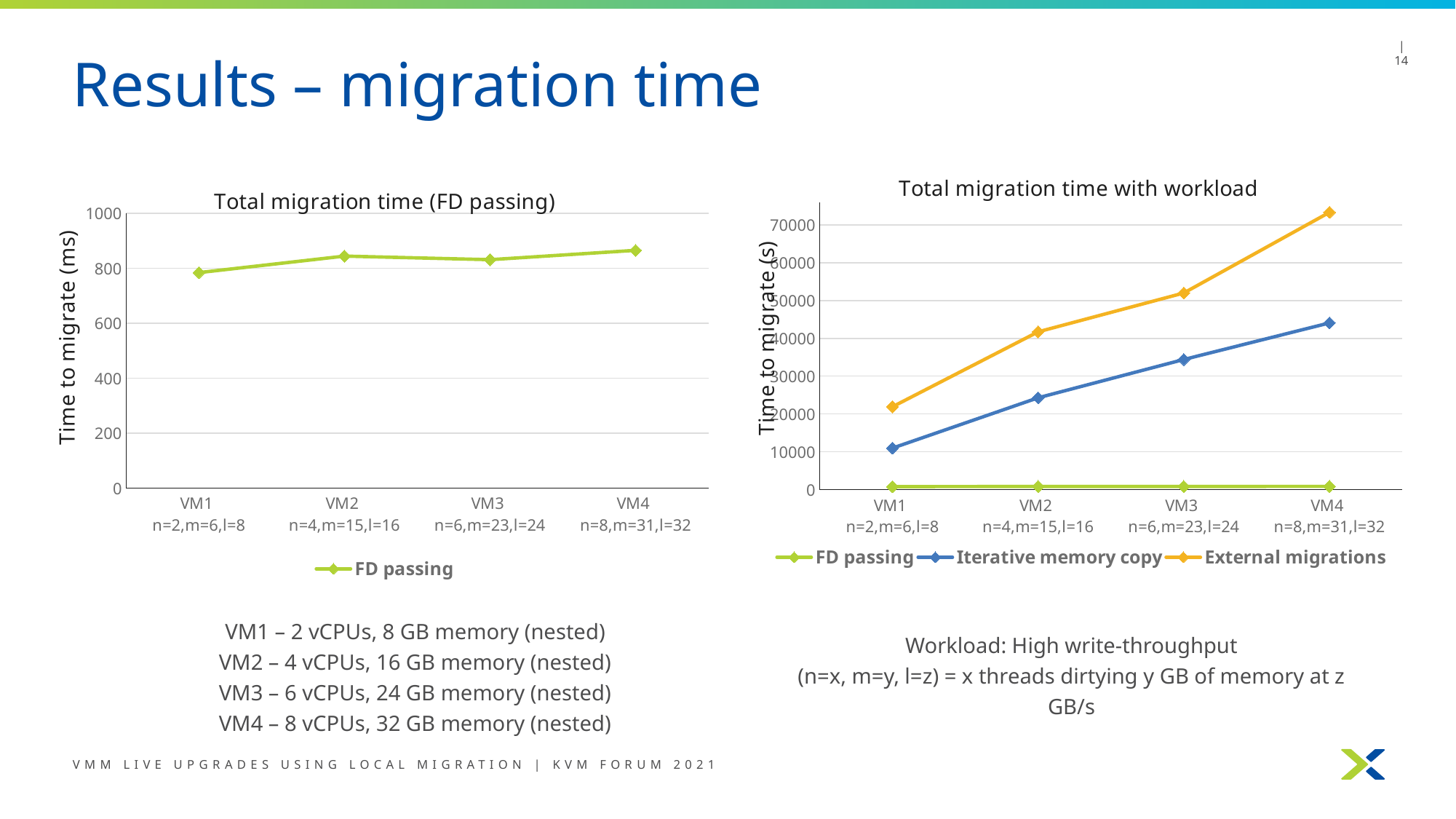
What is the y-axis label of the 'Total migration time with workload' chart? Time to migrate (s) In the 'Total migration time (FD passing)' chart, is the value for VM1 greater or less than 800? less In the 'Total migration time (FD passing)' chart, is the value for VM4 greater or less than 800? greater In the 'Total migration time (FD passing)' chart, which VM has the lowest migration time? VM1 What kind of chart is the 'Total migration time (FD passing)' chart on the left? line chart How many VM categories are shown on the x axis of the 'Total migration time with workload' chart? 4 In the 'Total migration time with workload' chart, is the Iterative memory copy value for VM1 greater or less than 20000? less In the 'Total migration time with workload' chart, do the External migrations values rise or fall from VM1 to VM4? rise In the 'Total migration time with workload' chart, which series has the highest value at VM4? External migrations In the 'Total migration time with workload' chart, which is larger at VM2: Iterative memory copy or External migrations? External migrations How many series does the legend of the 'Total migration time with workload' chart list? 3